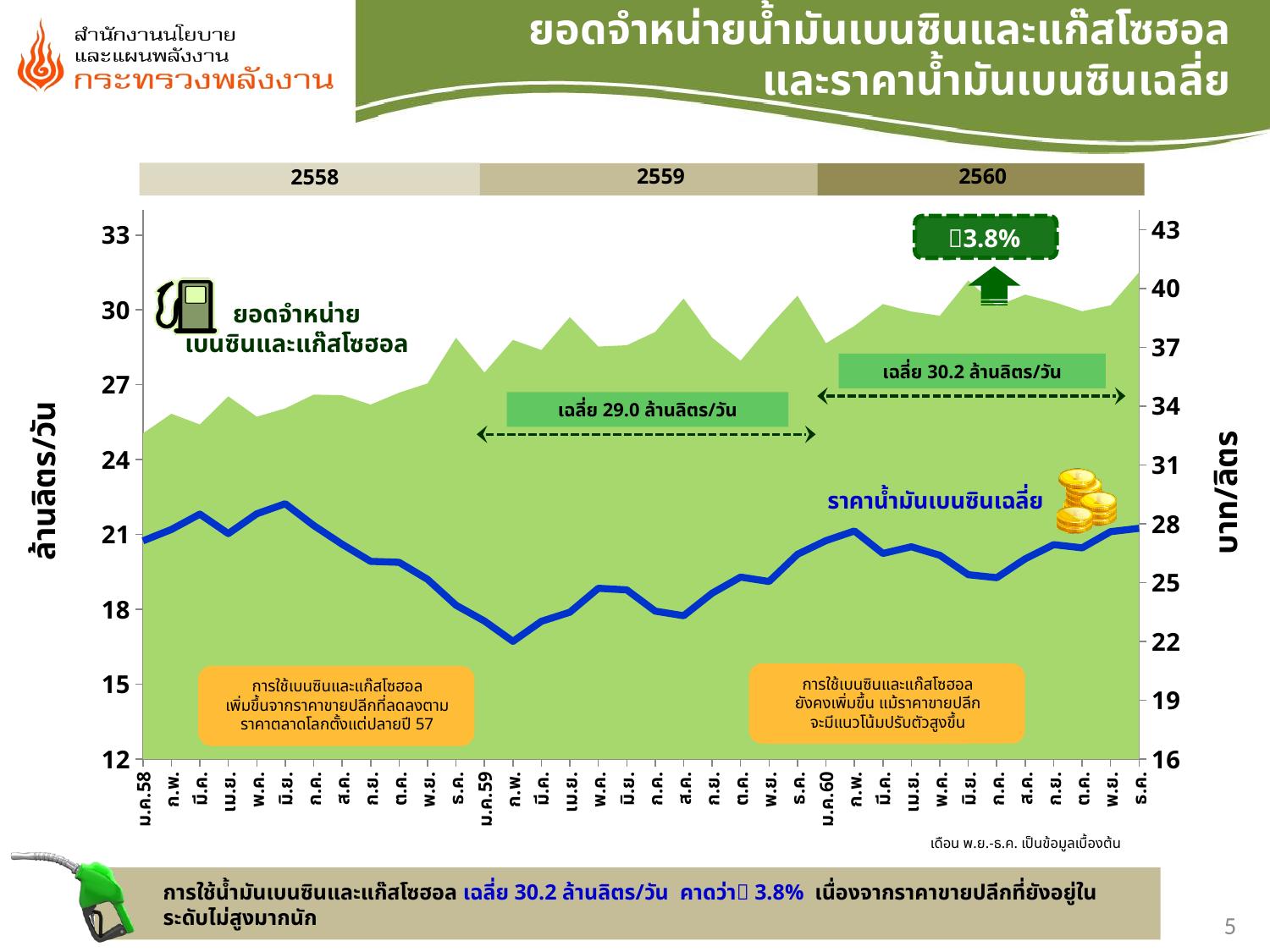
Does the average gasoline price (blue line) rise or fall from ม.ค.58 to ก.พ.59? fall How many data series are plotted on the chart? 2 What unit is shown on the right vertical axis? บาท/ลิตร What is the average daily sales of gasoline and gasohol shown for 2560? 30.2 ล้านลิตร/วัน What growth percentage is shown in the green box at the top of the chart? 3.8% Is the sales value (green area) for ธ.ค. 2560 greater or less than 30 on the left axis? greater Which year has the larger printed average daily sales, 2559 or 2560? 2560 What is the average daily sales of gasoline and gasohol shown for 2559? 29.0 ล้านลิตร/วัน Is the sales value (green area) for ม.ค.58 greater or less than 27 on the left axis? less What is the difference between the 2560 average and the 2559 average daily sales? 1.2 ล้านลิตร/วัน What kind of chart is shown on the slide? area and line chart